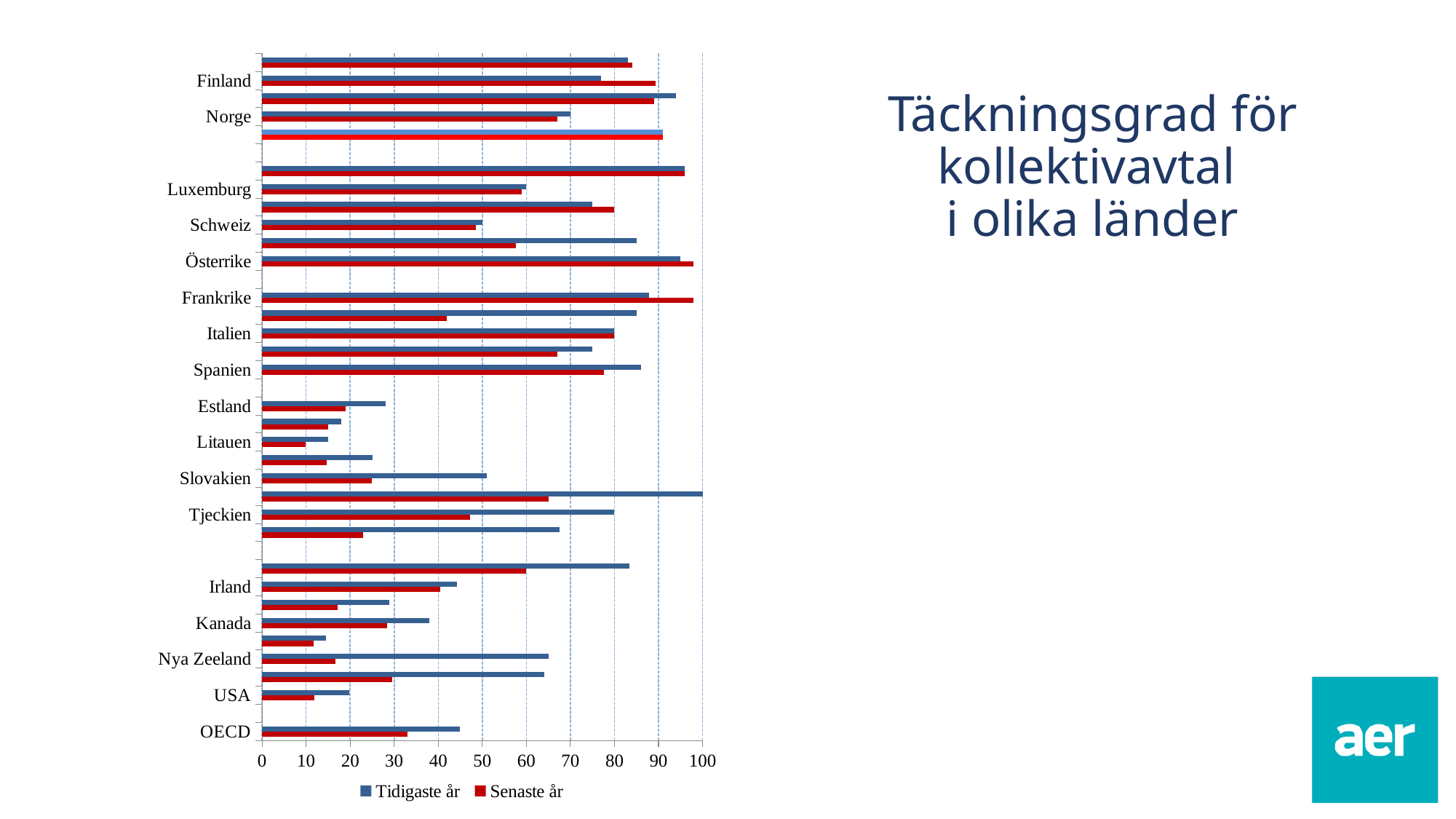
For Nya Zeeland, which is larger: Tidigaste år or Senaste år? Tidigaste år Is the Tidigaste år value for Slovakien greater or less than 40? greater For Frankrike, which is larger: Tidigaste år or Senaste år? Senaste år What kind of chart is shown on the slide? Bar chart Is the Tidigaste år value for Litauen greater or less than 20? less Is the Senaste år value for OECD greater or less than 40? less Which series is drawn in red according to the legend? Senaste år How many series does the legend list? 2 What is the title shown next to the chart? Täckningsgrad för kollektivavtal i olika länder For Tjeckien, which is larger: Tidigaste år or Senaste år? Tidigaste år